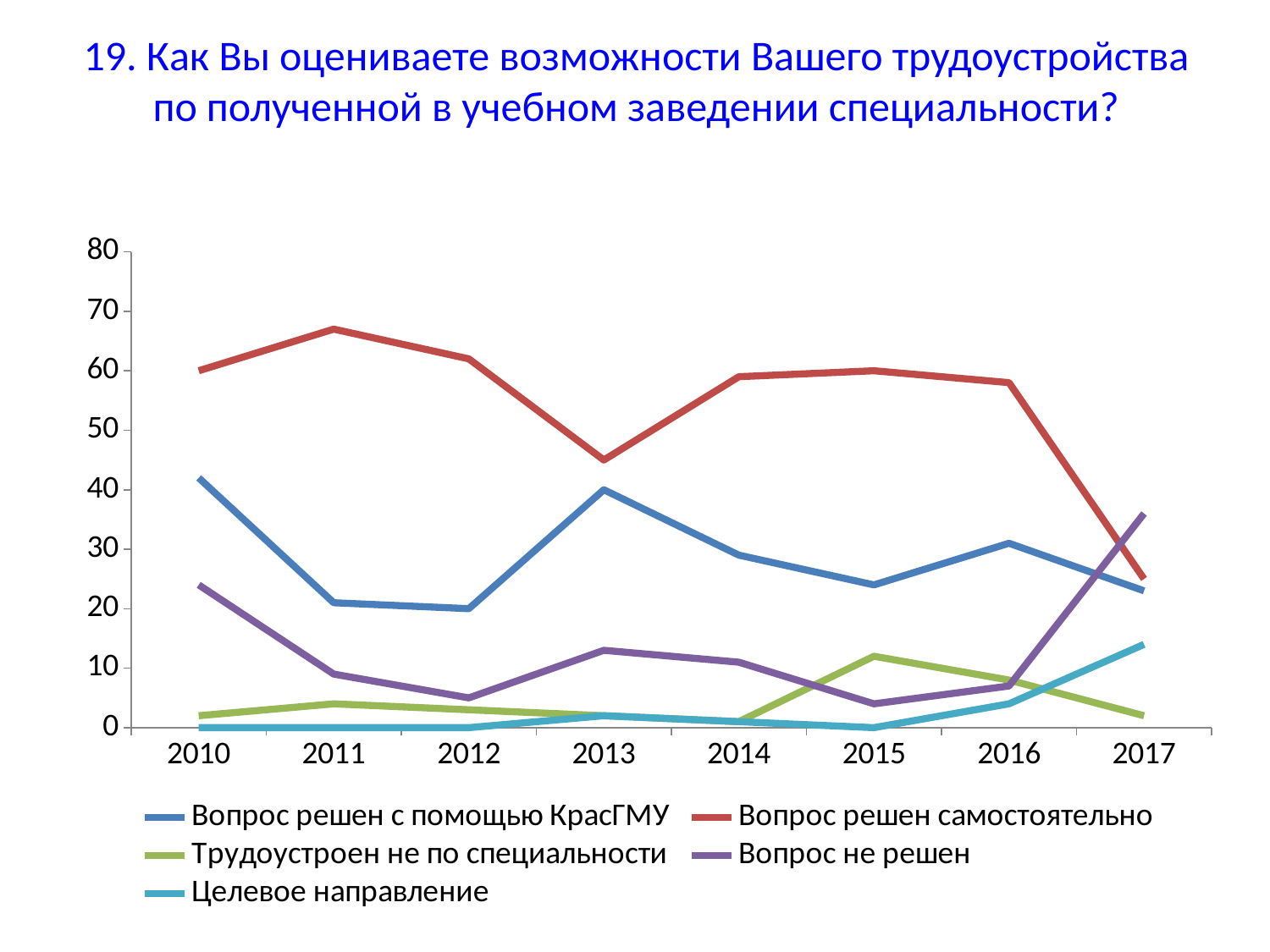
What kind of chart is shown on the slide? line chart Is the value for "Вопрос решен самостоятельно" in 2013 greater or less than 50? less How many years are shown on the x axis? 8 In which year is the value for "Вопрос не решен" highest? 2017 How many series does the legend list? 5 Does the value for "Вопрос решен самостоятельно" rise or fall from 2015 to 2017? fall In which year is the value for "Вопрос решен самостоятельно" highest? 2011 Is the value for "Вопрос решен с помощью КрасГМУ" in 2010 greater or less than 30? greater What colour is the line for "Вопрос решен самостоятельно"? red In 2017, which is higher: "Вопрос не решен" or "Вопрос решен самостоятельно"? Вопрос не решен In which year is the value for "Трудоустроен не по специальности" highest? 2015 In which year is the value for "Вопрос решен самостоятельно" lowest? 2017